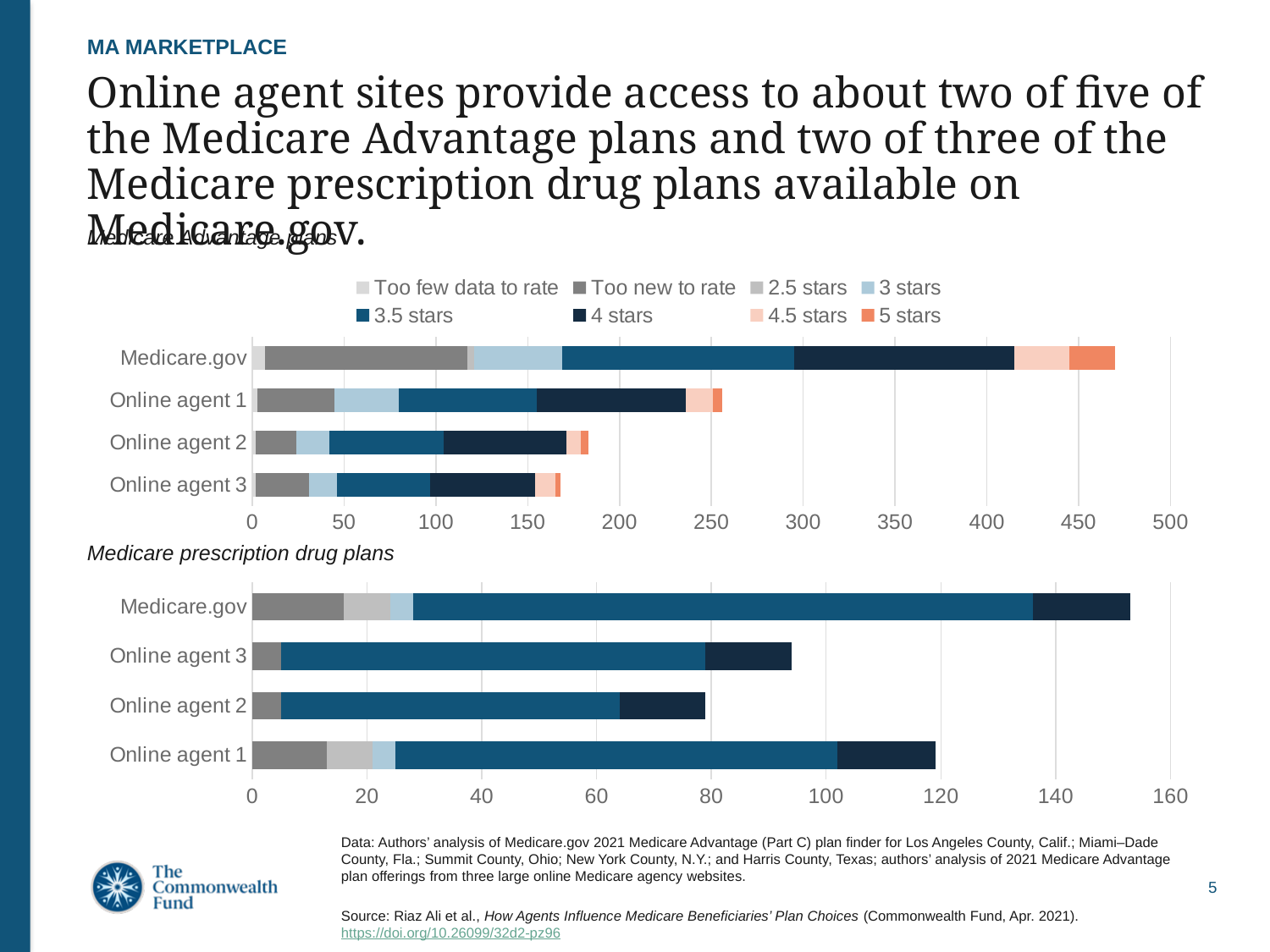
What kind of chart is the Medicare Advantage plans chart? Stacked bar chart In the Medicare prescription drug plans chart, which category has the longest total bar? Medicare.gov In the Medicare prescription drug plans chart, which category has the shortest total bar? Online agent 2 In the Medicare prescription drug plans chart, is the total for Online agent 3 greater or less than 100? less In the Medicare Advantage plans chart, which category has the longest total bar? Medicare.gov In the Medicare Advantage plans chart, is the total for Medicare.gov greater or less than 450? greater In the Medicare Advantage plans chart, is the total for Online agent 2 greater or less than 200? less How many series does the legend list? 8 In the Medicare prescription drug plans chart, which has a longer total bar, Online agent 1 or Online agent 3? Online agent 1 How many categories are shown in the Medicare prescription drug plans chart? 4 In the Medicare Advantage plans chart, which category has the shortest total bar? Online agent 3